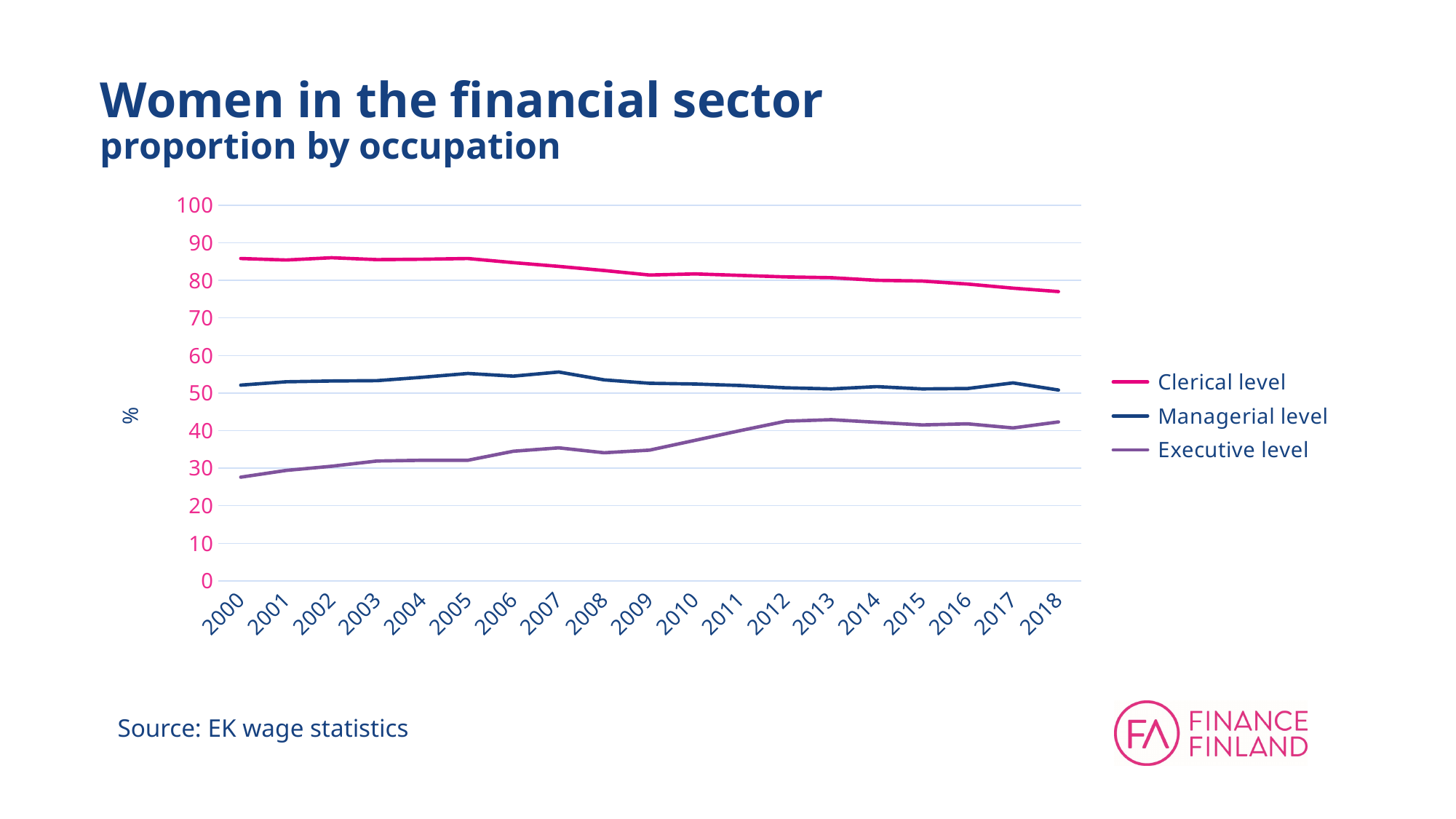
Does the Executive level line rise or fall from 2000 to 2018? rise What kind of chart is shown on the slide? line chart How many years are plotted along the x axis? 19 Is the value for Executive level in 2013 greater or less than 40? greater What are the three series named in the legend? Clerical level, Managerial level, Executive level Is the value for Managerial level in 2018 greater or less than 60? less What source is cited for the chart? EK wage statistics Is the value for Clerical level in 2000 greater or less than 80? greater How many series does the legend list? 3 Does the Clerical level line rise or fall from 2000 to 2018? fall